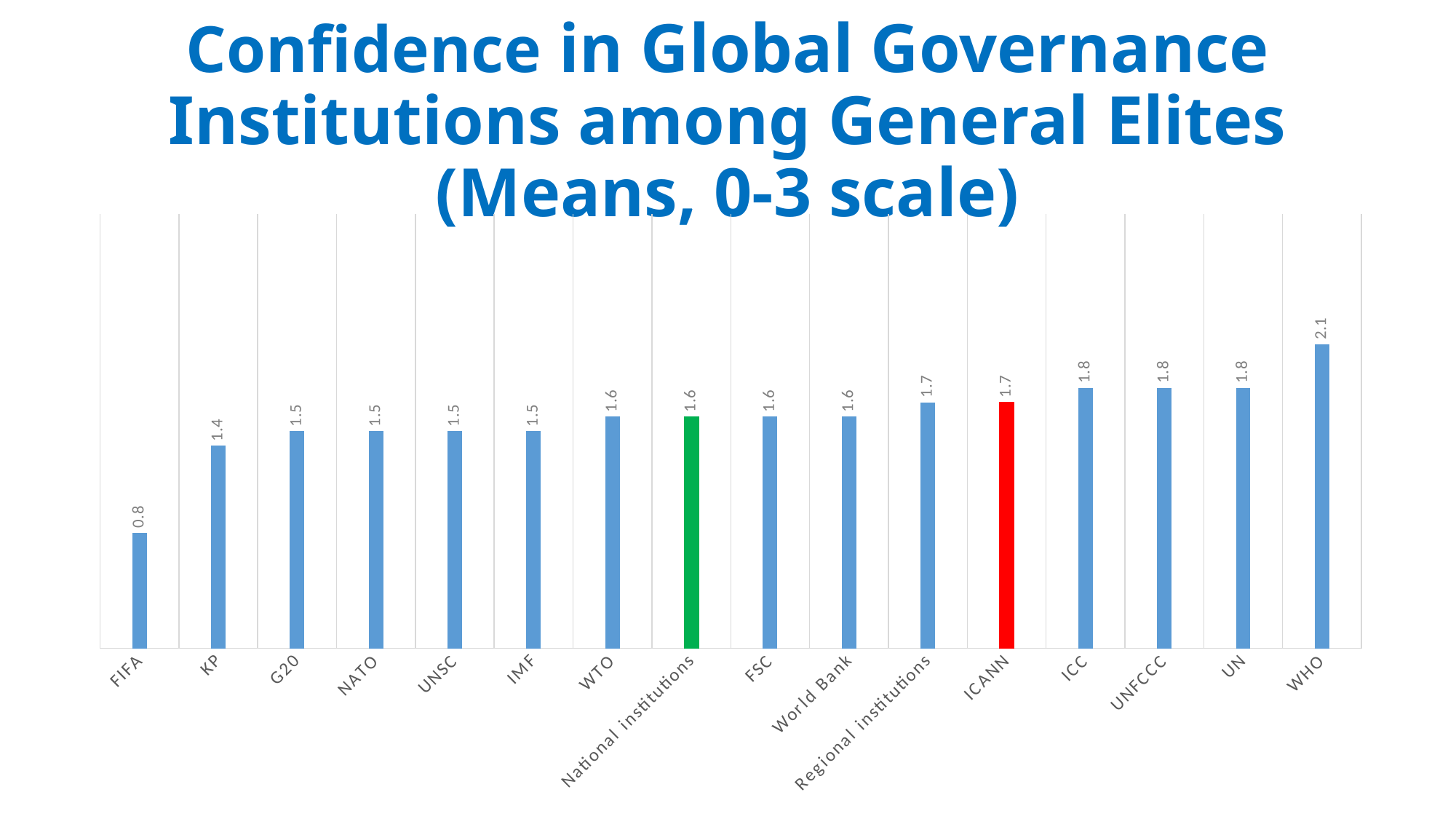
What is the value for ICANN? 1.7 What is the value for FIFA? 0.8 Which is larger, the value for UN or the value for World Bank? UN What is the difference between the values for WHO and FIFA? 1.3 What kind of chart is this? Bar chart How many institutions are shown on the chart? 16 What is the difference between the values for ICANN and KP? 0.3 Which bar is coloured red? ICANN Which institution has the highest confidence value? WHO Which institution has the lowest confidence value? FIFA What is the value for WHO? 2.1 What is the value for National institutions? 1.6